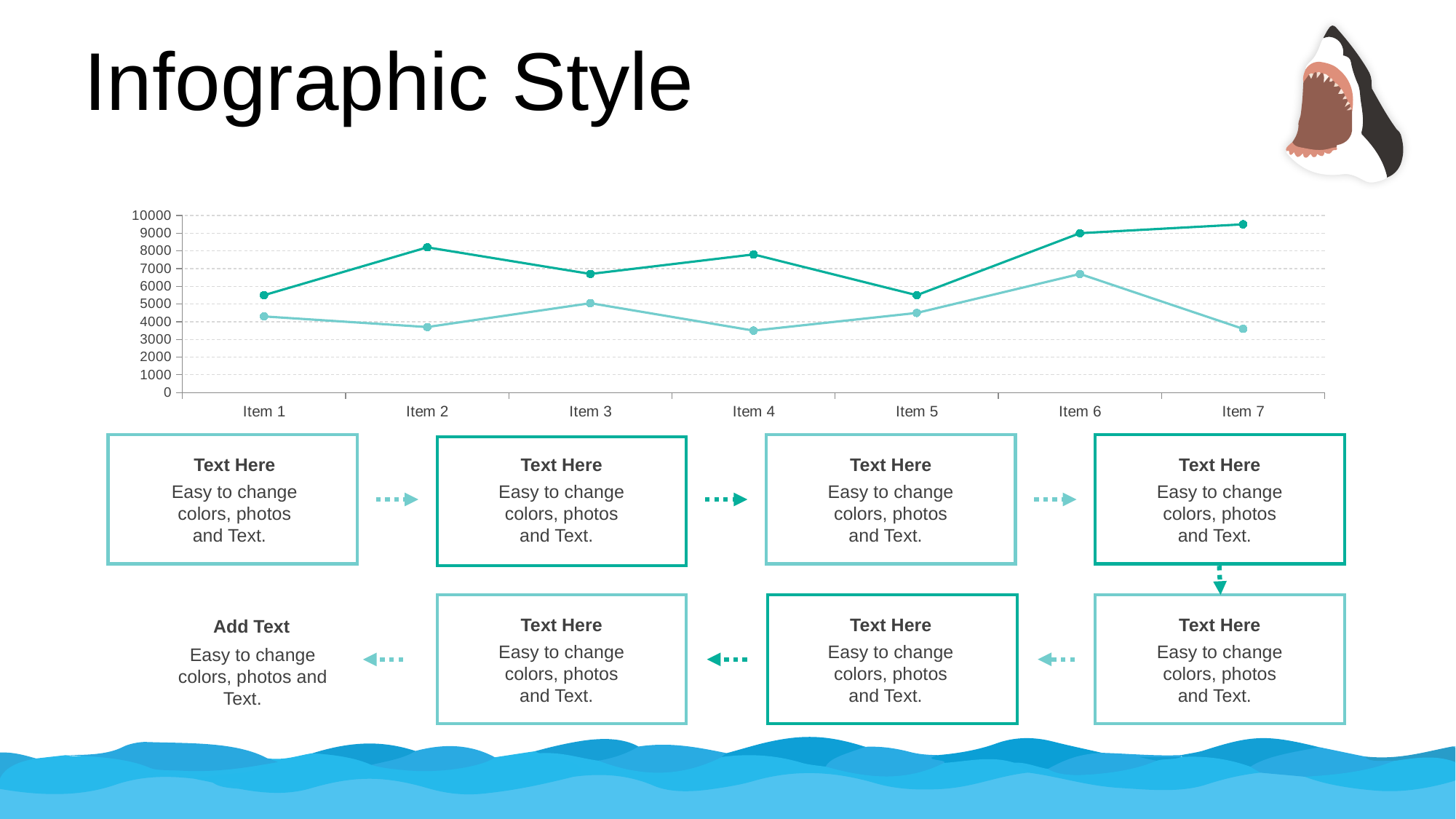
What kind of chart is shown on the slide? Line chart At which item does the lighter line reach its highest value? Item 6 Does the darker line rise or fall from Item 5 to Item 7? Rise How many categories are shown on the x axis of the chart? 7 Is the value of the darker line at Item 1 greater or less than 5000? greater At which item does the darker line reach its highest value? Item 7 For the darker line, is the value at Item 2 or at Item 3 larger? Item 2 How many lines (series) are plotted on the chart? 2 Is the value of the lighter line at Item 4 greater or less than 4000? less Is the value of the lighter line at Item 6 greater or less than 6000? greater What is the highest value shown on the chart's y axis? 10000